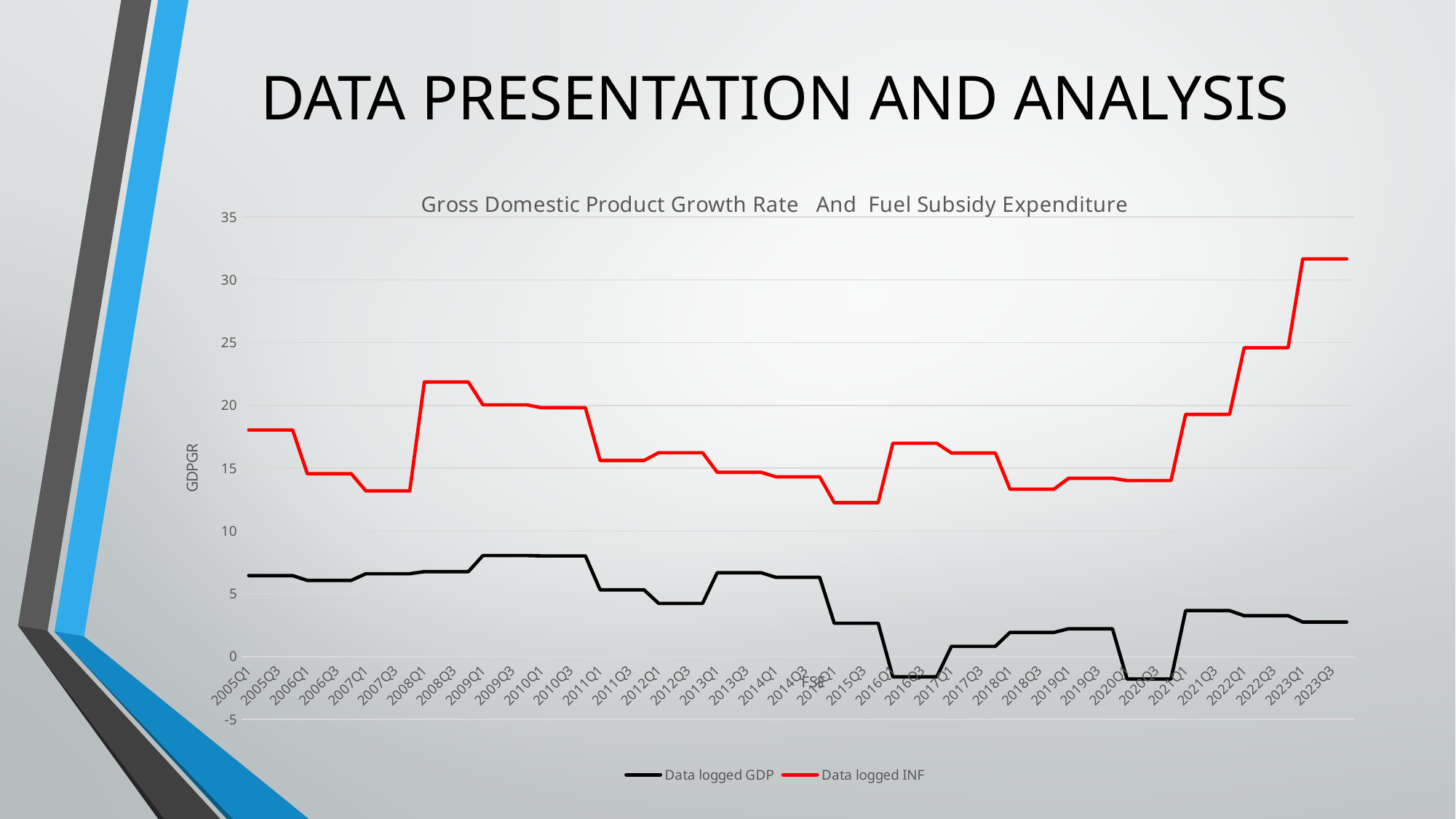
Is the value of Data logged INF at 2015Q1 greater or less than 15? less What kind of chart is shown on the slide? Line chart Does the Data logged INF line rise or fall from 2021Q1 to 2023Q3? Rise Is the value of Data logged INF at 2023Q3 greater or less than 30? greater Which series has the higher values across the whole chart? Data logged INF Is the value of Data logged GDP at 2016Q1 greater or less than 0? less What colour is the line for Data logged INF? Red How many series does the legend list? 2 At 2023Q3, which series has the larger value, Data logged GDP or Data logged INF? Data logged INF What is the title of the chart? Gross Domestic Product Growth Rate And Fuel Subsidy Expenditure